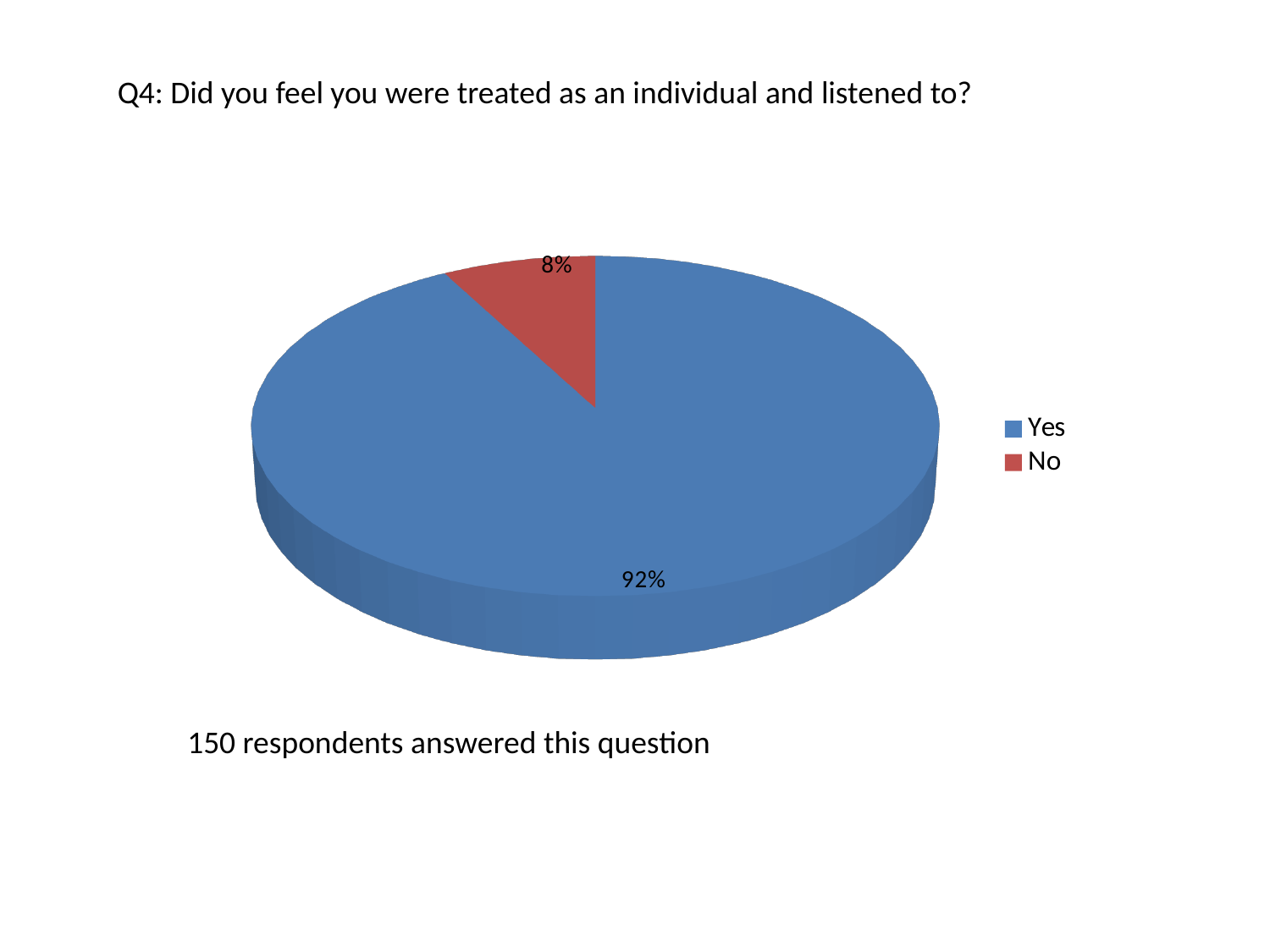
Which response has the smallest share of the pie? No What is the difference in percentage points between the Yes and No shares? 84 What percentage of respondents answered No? 8% Which response has the largest share of the pie? Yes How many entries does the legend list? 2 What colour is the Yes slice? Blue How many respondents answered this question according to the slide? 150 How many categories does the pie chart show? 2 What percentage of respondents answered Yes? 92% What share of the pie does the No slice represent? 8% What kind of chart is shown on the slide? Pie chart Which is larger, the share for Yes or the share for No? Yes